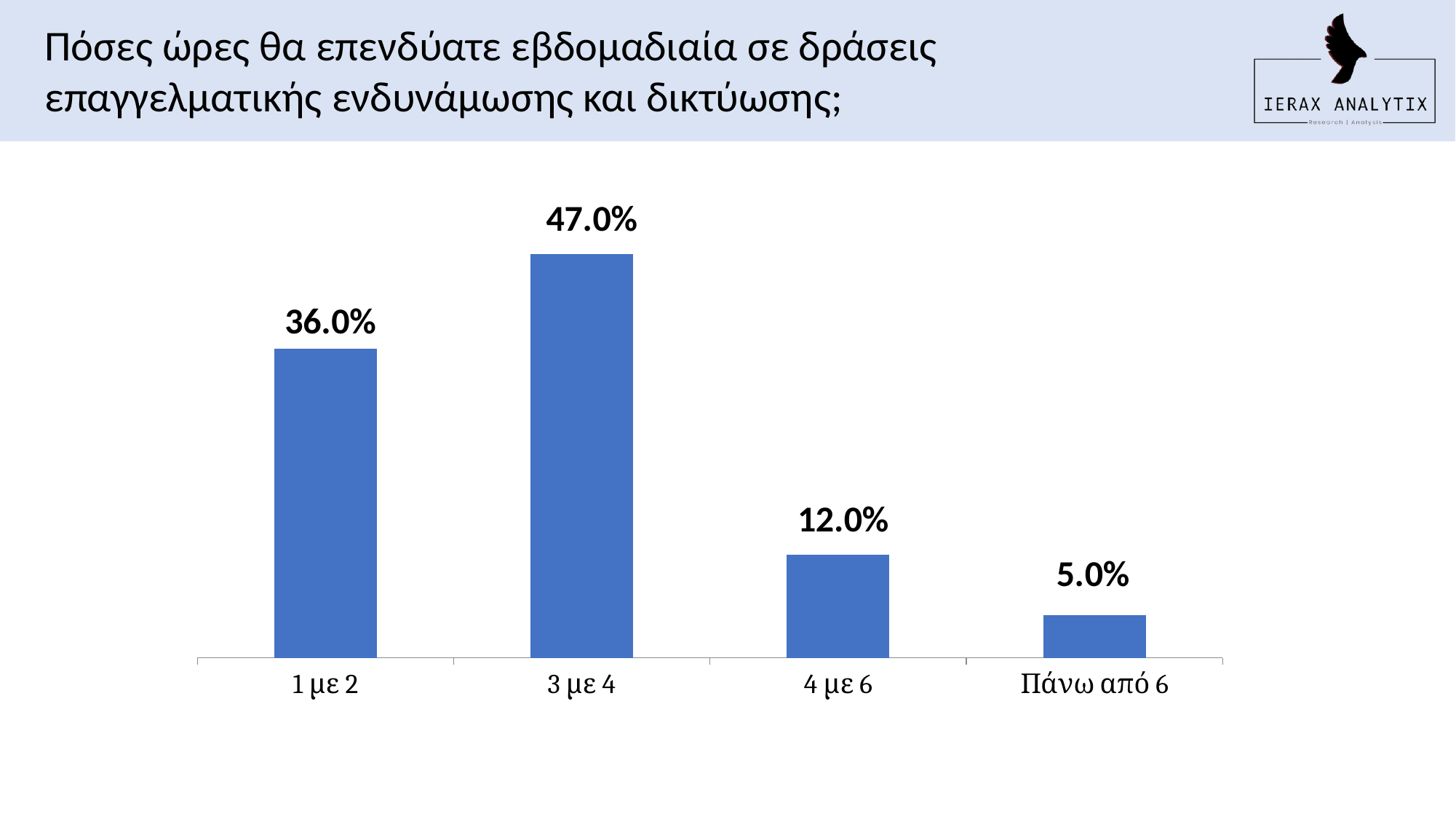
Which is larger, the value for "1 με 2" or the value for "4 με 6"? 1 με 2 What is the value for the "1 με 2" category? 36.0% What is the value for the "4 με 6" category? 12.0% What is the difference between the values for "4 με 6" and "Πάνω από 6"? 7.0% Which category has the lowest value? Πάνω από 6 Which category has the highest value? 3 με 4 What is the value for the "3 με 4" category? 47.0% What is the difference between the values for "3 με 4" and "1 με 2"? 11.0% What is the value for the "Πάνω από 6" category? 5.0% What kind of chart is shown on the slide? Bar chart What is the title of the slide containing the chart? Πόσες ώρες θα επενδύατε εβδομαδιαία σε δράσεις επαγγελματικής ενδυνάμωσης και δικτύωσης; How many categories are shown on the chart? 4